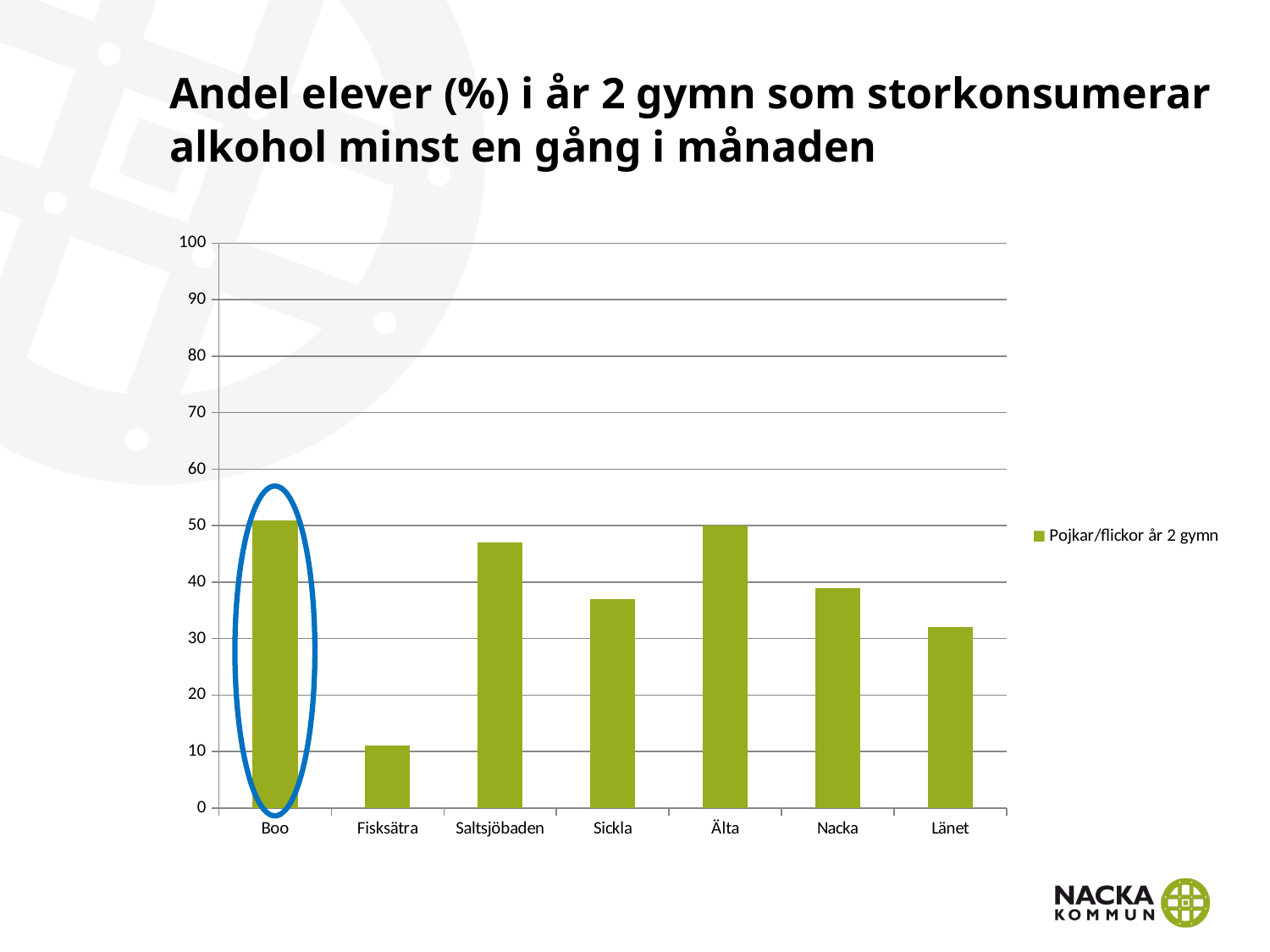
Which is larger, the value for Nacka or the value for Länet? Nacka Is the value for Fisksätra greater or less than 20? less What is the name of the series listed in the legend? Pojkar/flickor år 2 gymn How many categories are shown on the x axis of the chart? 7 Is the value for Länet greater or less than 40? less Which category has the lowest value in the chart? Fisksätra How many series does the legend list? 1 What kind of chart is shown on the slide? Bar chart Is the value for Saltsjöbaden greater or less than 40? greater Which is larger, the value for Saltsjöbaden or the value for Sickla? Saltsjöbaden Which category's bar is circled in blue on the chart? Boo